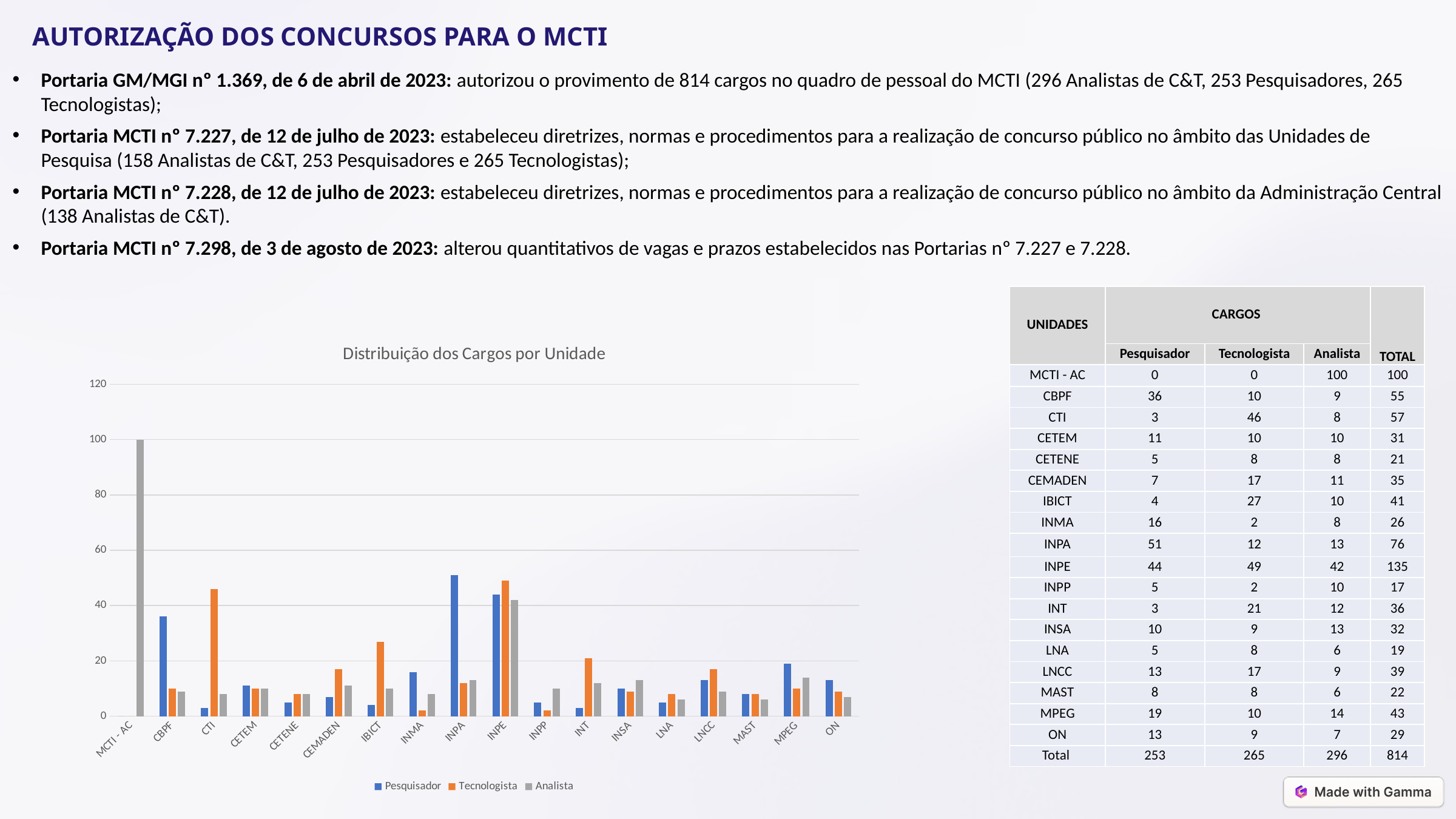
What colour represents the Tecnologista series in the chart 'Distribuição dos Cargos por Unidade'? orange In the chart 'Distribuição dos Cargos por Unidade', which is larger for IBICT: Pesquisador or Tecnologista? Tecnologista In the chart 'Distribuição dos Cargos por Unidade', is the Pesquisador value for CBPF greater or less than 20? greater In the chart 'Distribuição dos Cargos por Unidade', what is the Analista value for MCTI - AC? 100 In the chart 'Distribuição dos Cargos por Unidade', which unit has the highest Analista bar? MCTI - AC In the chart 'Distribuição dos Cargos por Unidade', which is larger for INPA: Pesquisador or Tecnologista? Pesquisador In the chart 'Distribuição dos Cargos por Unidade', which unit has the highest Pesquisador bar? INPA In the chart 'Distribuição dos Cargos por Unidade', is the Analista value for INPP greater or less than 20? less What kind of chart is 'Distribuição dos Cargos por Unidade'? bar chart In the chart 'Distribuição dos Cargos por Unidade', is the Tecnologista value for CTI greater or less than 40? greater How many series does the legend of the chart 'Distribuição dos Cargos por Unidade' list? 3 How many units (categories) are shown on the x axis of the chart 'Distribuição dos Cargos por Unidade'? 18